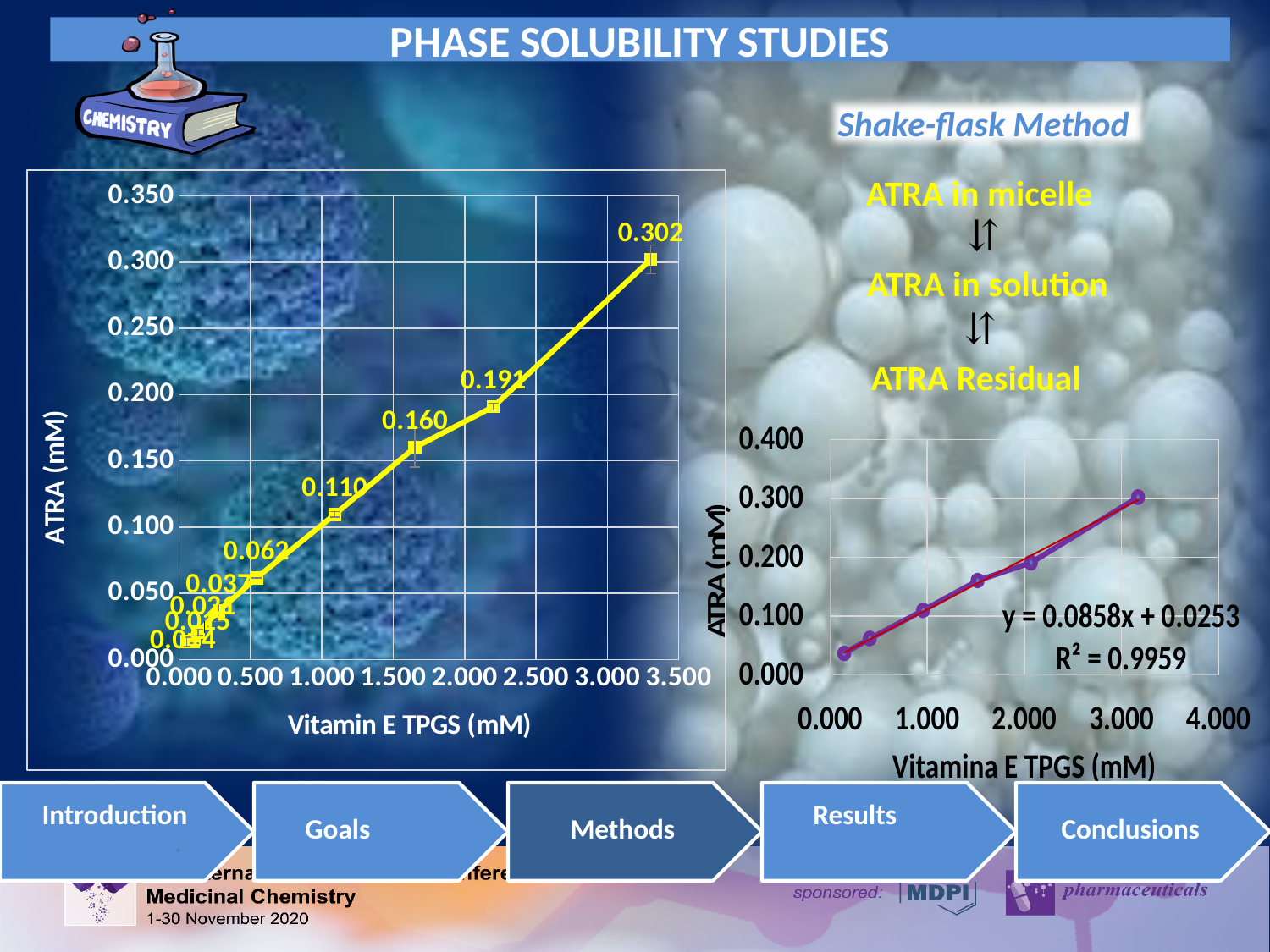
On the right chart, what is the trendline equation shown? y = 0.0858x + 0.0253 On the left chart, which labelled value is larger, 0.160 or 0.110? 0.160 What is the x-axis title of the left chart? Vitamin E TPGS (mM) On the left chart, what is the ATRA value labelled just below 0.302 on the line? 0.191 On the right chart, do the ATRA values rise or fall as Vitamina E TPGS increases? rise What kind of chart is the left chart? line chart On the left chart (ATRA vs Vitamin E TPGS), what is the highest labelled ATRA value? 0.302 On the left chart, do the ATRA values rise or fall as Vitamin E TPGS increases? rise On the left chart, what is the difference between the labelled values 0.160 and 0.110? 0.050 On the right chart, what is the R² value shown? 0.9959 On the right chart, is the ATRA value at 1.000 mM Vitamina E TPGS greater or less than 0.200? less On the left chart, what is the difference between the labelled values 0.302 and 0.191? 0.111